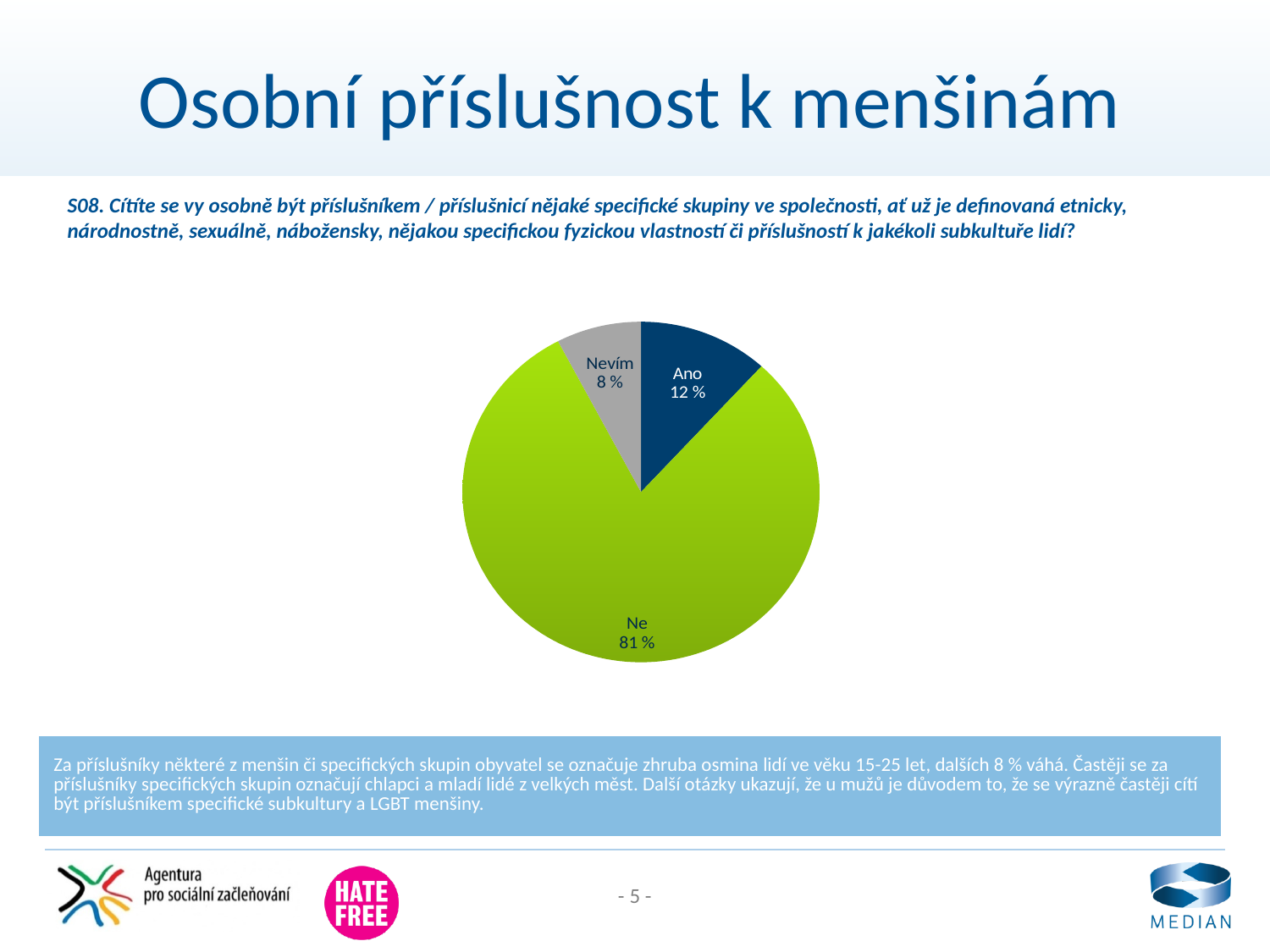
Which slice of the pie is the smallest? Nevím How many slices does the pie chart have? 3 Which is larger, the "Ano" slice or the "Nevím" slice? Ano What share of the pie does the "Ano" slice represent? 12 % What share of the pie does the "Ne" slice represent? 81 % Which slice of the pie is the largest? Ne What share of the pie does the "Nevím" slice represent? 8 % What colour is the "Ne" slice of the pie? green What colour is the "Ano" slice of the pie? dark blue What kind of chart is shown on the slide? pie chart What is the difference in percentage points between the "Ne" slice and the "Ano" slice? 69 % What is the difference in percentage points between the "Ano" slice and the "Nevím" slice? 4 %